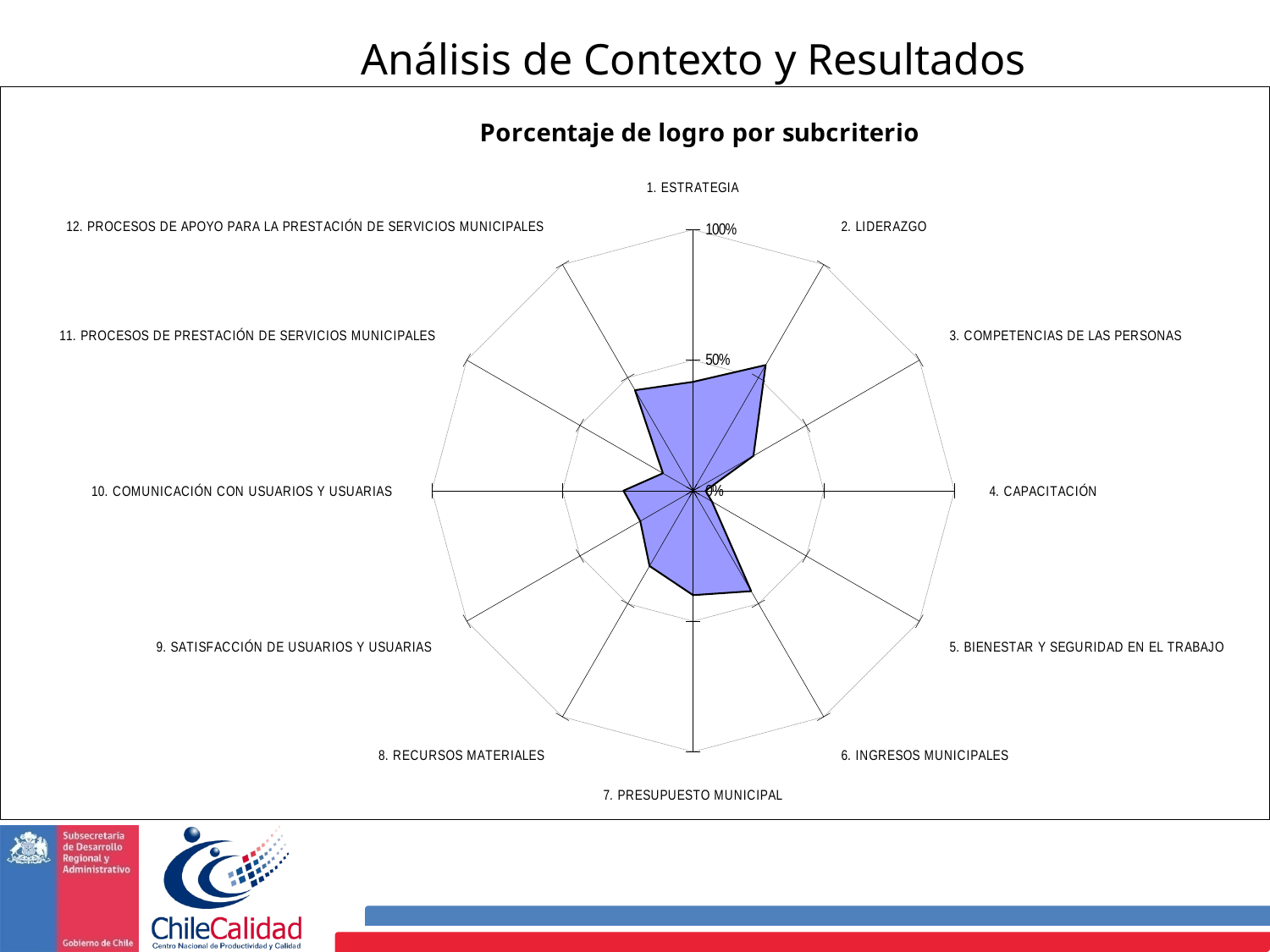
What is the maximum value shown on the chart's axis scale? 100% What is the title of the chart? Porcentaje de logro por subcriterio Is the value for 7. PRESUPUESTO MUNICIPAL greater or less than 50%? less What kind of chart is shown on the slide? Radar chart Is the value for 9. SATISFACCIÓN DE USUARIOS Y USUARIAS greater or less than 50%? less How many subcriteria (categories) are plotted on the radar chart? 12 Is the value for 4. CAPACITACIÓN greater or less than 50%? less Which has a higher value: 2. LIDERAZGO or 4. CAPACITACIÓN? 2. LIDERAZGO Which has a higher value: 7. PRESUPUESTO MUNICIPAL or 3. COMPETENCIAS DE LAS PERSONAS? 7. PRESUPUESTO MUNICIPAL Which subcriterion has the highest percentage of achievement? 2. LIDERAZGO